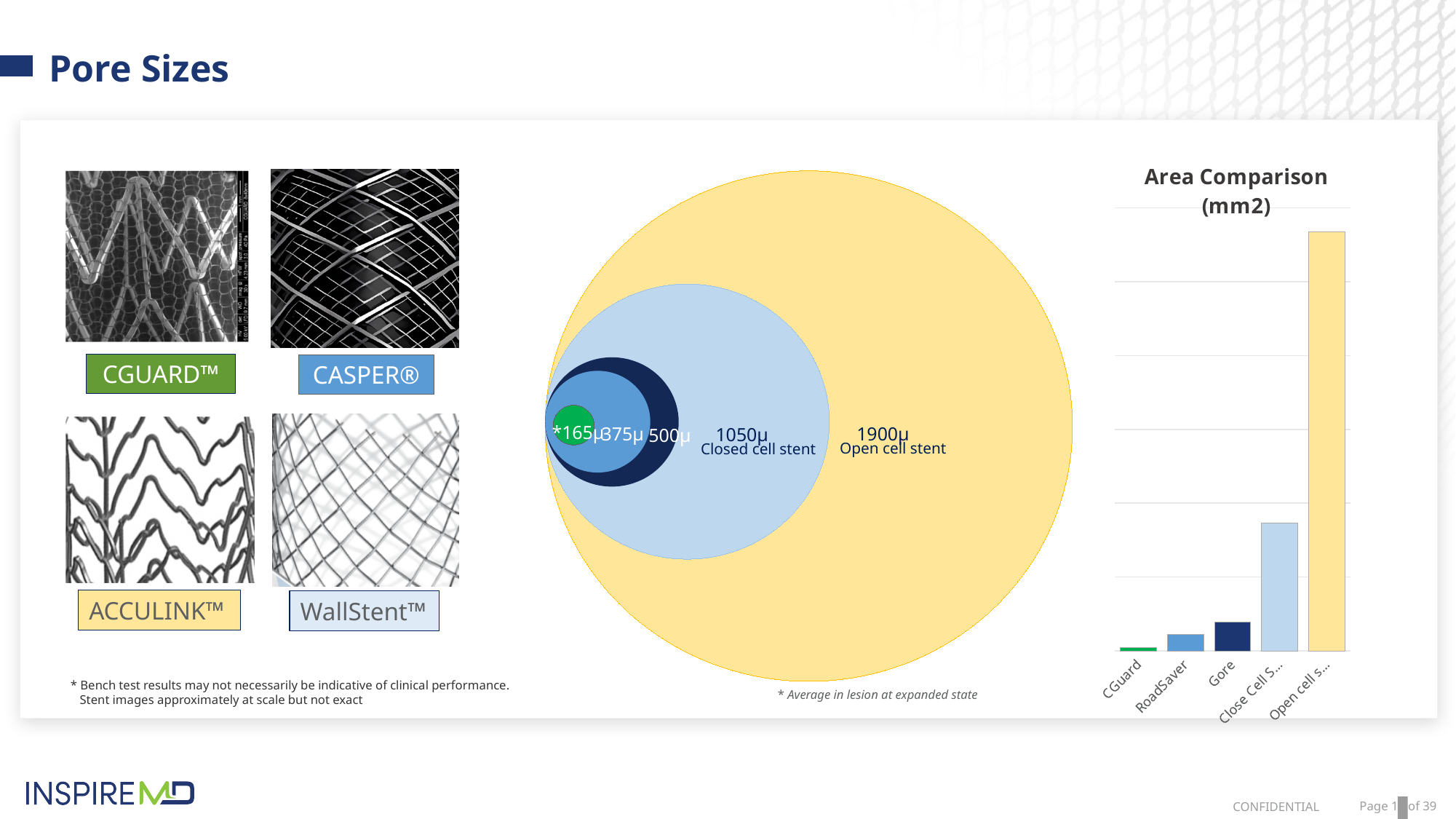
In the "Area Comparison (mm2)" chart, how many categories are plotted? 5 In the "Area Comparison (mm2)" chart, which is larger, the bar for CGuard or the bar for RoadSaver? RoadSaver In the "Area Comparison (mm2)" chart, which category has the highest bar? Open cell s... What kind of chart is the "Area Comparison (mm2)" chart? bar chart In the "Area Comparison (mm2)" chart, do the bar heights rise or fall from left to right? rise In the "Area Comparison (mm2)" chart, which category has the lowest bar? CGuard In the "Area Comparison (mm2)" chart, what colour is the CGuard bar? green In the "Area Comparison (mm2)" chart, which is larger, the bar for Gore or the bar for RoadSaver? Gore In the "Area Comparison (mm2)" chart, which is larger, the bar for Close Cell S... or the bar for Gore? Close Cell S... What is the title of the bar chart on the right of the slide? Area Comparison (mm2) In the "Area Comparison (mm2)" chart, which category is plotted first on the left? CGuard